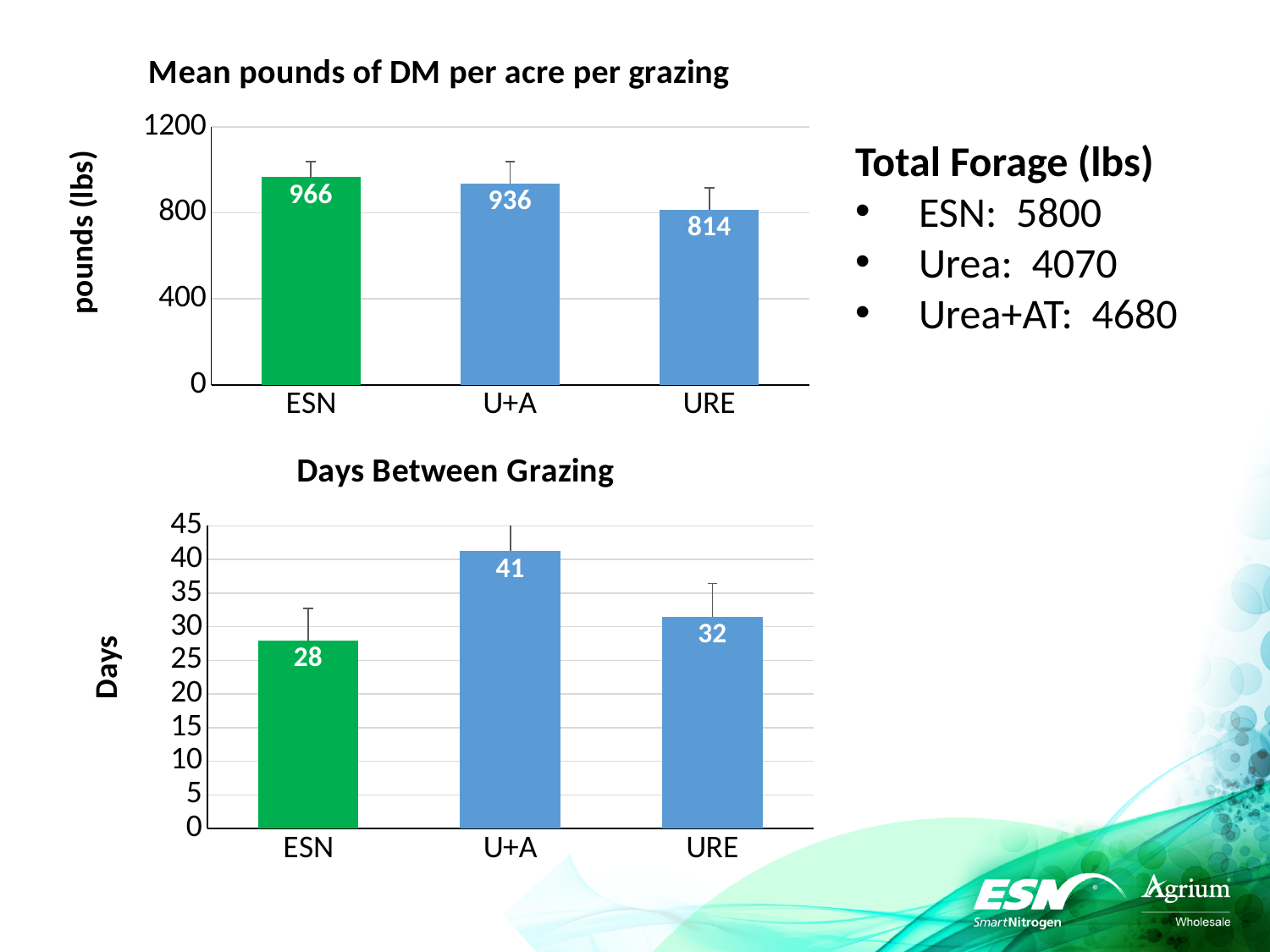
In the 'Mean pounds of DM per acre per grazing' chart, what kind of chart is shown? bar chart In the 'Mean pounds of DM per acre per grazing' chart, what is the value for ESN? 966 In the 'Mean pounds of DM per acre per grazing' chart, which category has the lowest value? URE In the 'Mean pounds of DM per acre per grazing' chart, what is the value for URE? 814 In the 'Days Between Grazing' chart, which is larger, the value for URE or the value for ESN? URE In the 'Days Between Grazing' chart, how many categories are shown on the x axis? 3 In the 'Mean pounds of DM per acre per grazing' chart, what is the difference between the ESN and URE values? 152 In the 'Days Between Grazing' chart, what is the difference between the U+A and ESN values? 13 In the 'Days Between Grazing' chart, what is the value for ESN? 28 In the 'Mean pounds of DM per acre per grazing' chart, is the value for U+A greater or less than 800? greater In the 'Days Between Grazing' chart, which category has the highest value? U+A In the 'Days Between Grazing' chart, what is the value for U+A? 41